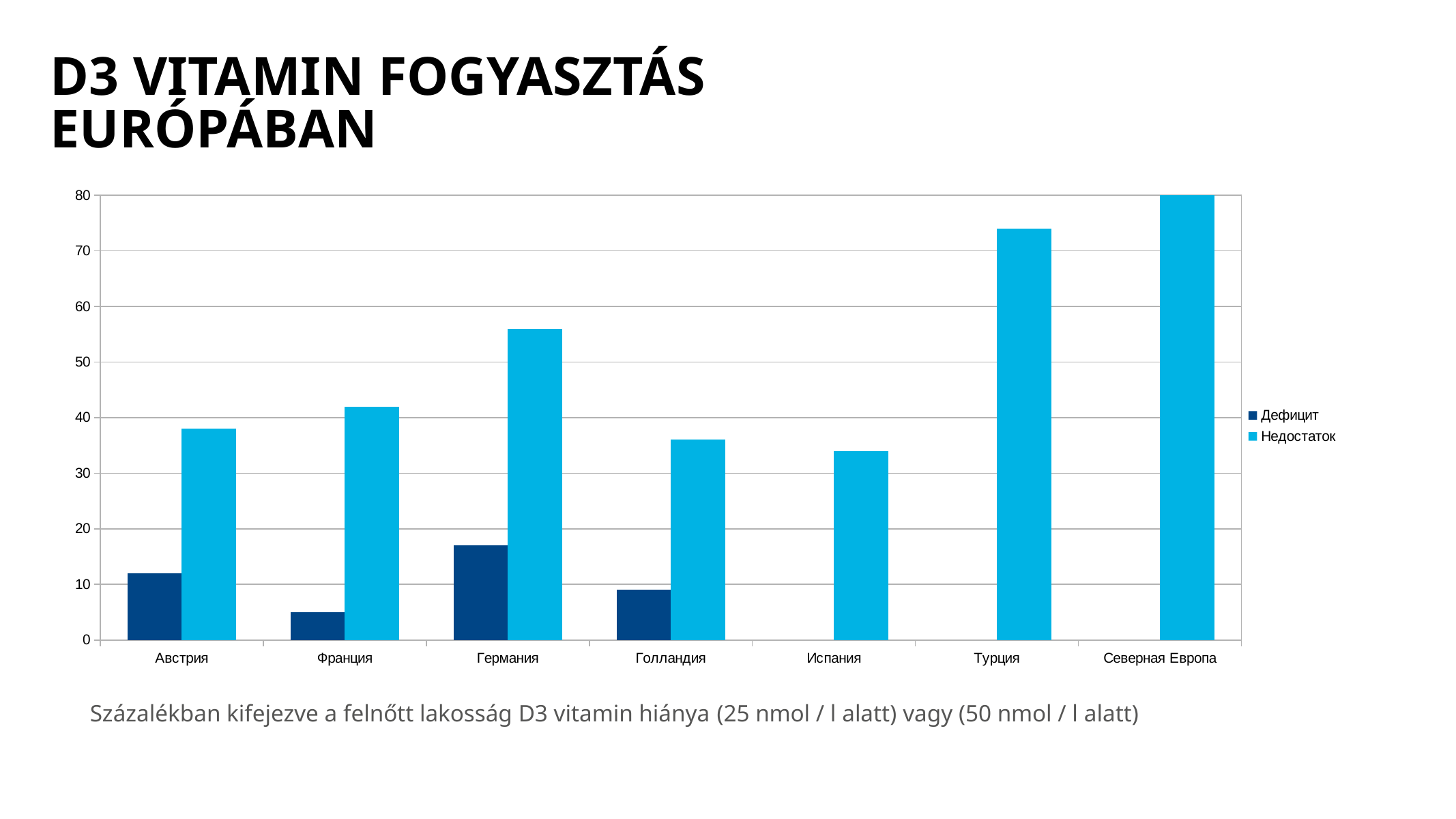
Is the Недостаток value for Турция greater or less than 70? greater Which category has the highest Недостаток value? Северная Европа What is the Недостаток value for Северная Европа? 80 Which category has the highest Дефицит value? Германия How many categories are shown on the x axis? 7 What are the two entries listed in the legend? Дефицит and Недостаток Is the Дефицит value for Франция greater or less than 10? less Which is larger, the Недостаток value for Турция or for Германия? Турция Is the Недостаток value for Германия greater or less than 50? greater Which category has the lowest Дефицит bar among those that have one? Франция How many series does the legend list? 2 What type of chart is shown on the slide? bar chart